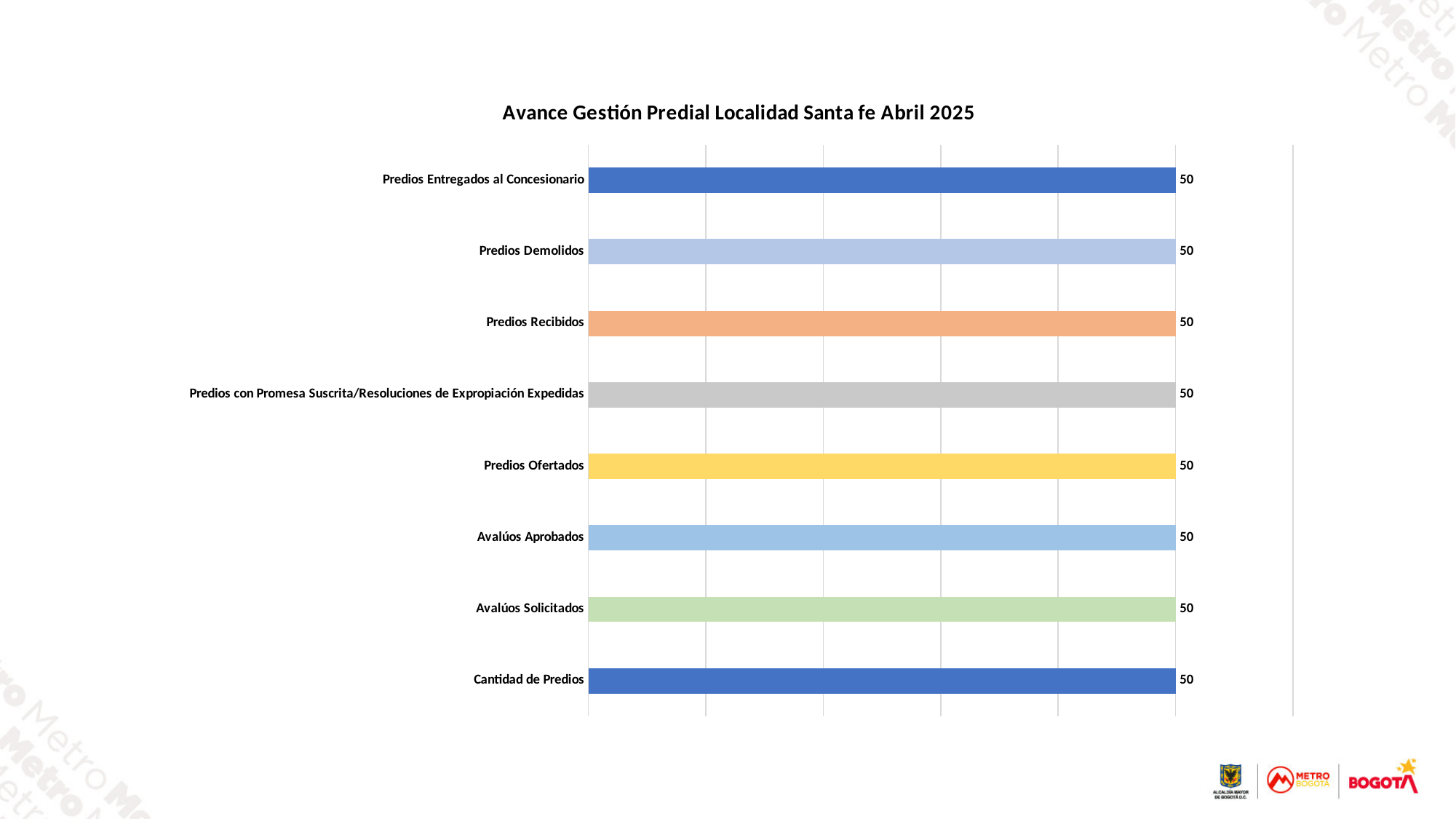
What is the value for Predios Ofertados? 50 How many categories are shown in the chart? 8 What is the value for Predios Demolidos? 50 What is the difference between the values for Cantidad de Predios and Avalúos Solicitados? 0 What is the value for Predios con Promesa Suscrita/Resoluciones de Expropiación Expedidas? 50 What is the value for Avalúos Aprobados? 50 What is the title of the chart? Avance Gestión Predial Localidad Santa fe Abril 2025 What kind of chart is shown on the slide? Bar chart What is the value for Predios Recibidos? 50 What is the value for Predios Entregados al Concesionario? 50 What is the value for Cantidad de Predios? 50 Is the value for Predios Ofertados larger than, smaller than, or equal to the value for Predios Recibidos? Equal